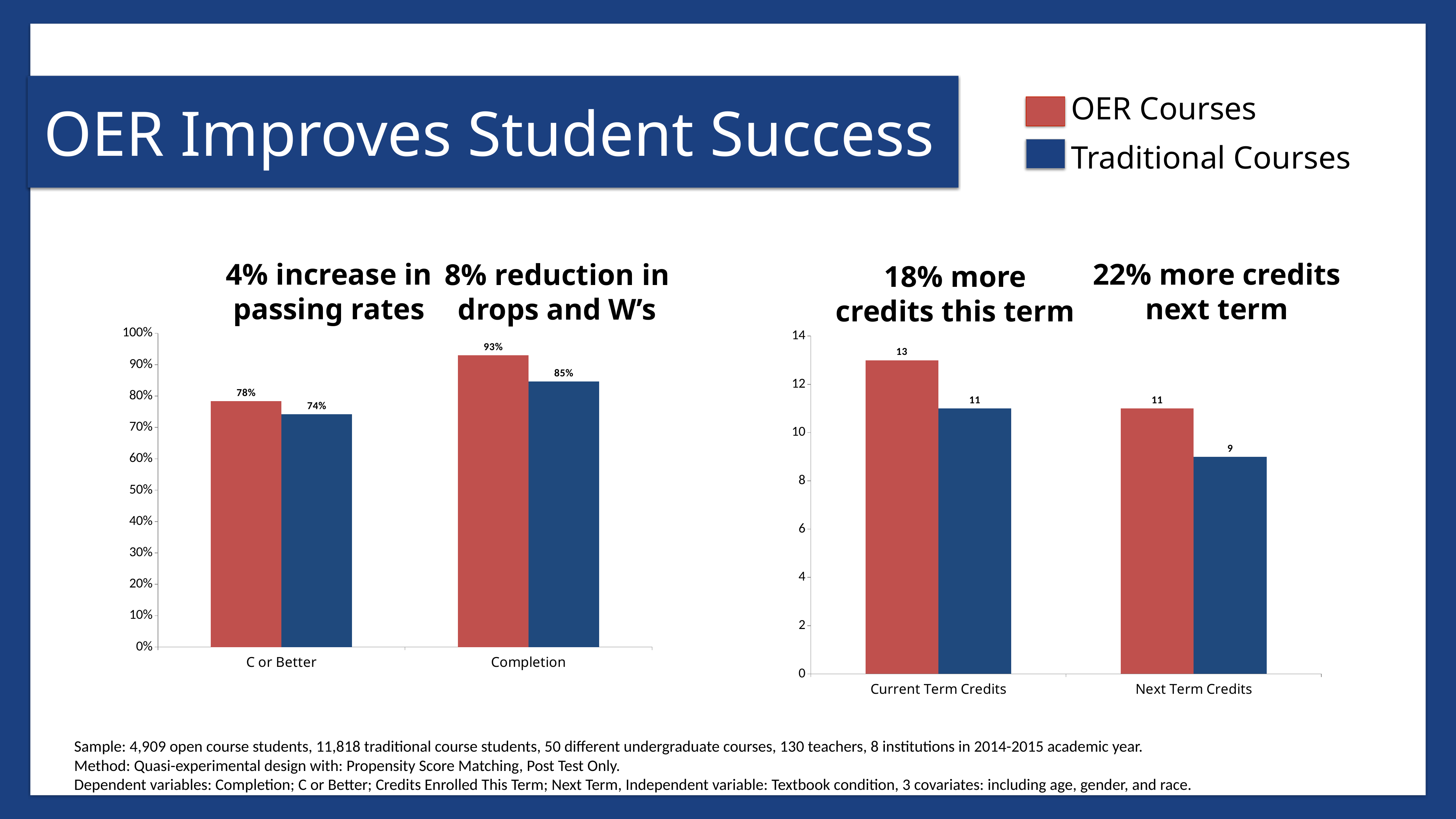
What type of chart is the left chart? Bar chart How many categories are shown on the x axis of the right chart? 2 How many series does the legend list? 2 In the left chart, which series has the higher value in the C or Better category? OER Courses In the right chart, what is the value for Traditional Courses in Next Term Credits? 9 In the left chart, what is the value for Traditional Courses in the Completion category? 85% In the left chart, what is the value for OER Courses in the C or Better category? 78% In the right chart, what is the value for OER Courses in Current Term Credits? 13 In the left chart, is the value for Traditional Courses in C or Better greater or less than 80%? less In the left chart, what is the difference between OER Courses and Traditional Courses in the Completion category? 8% In the right chart, what is the difference between OER Courses and Traditional Courses in Next Term Credits? 2 In the right chart, which category has the lowest bar? Next Term Credits